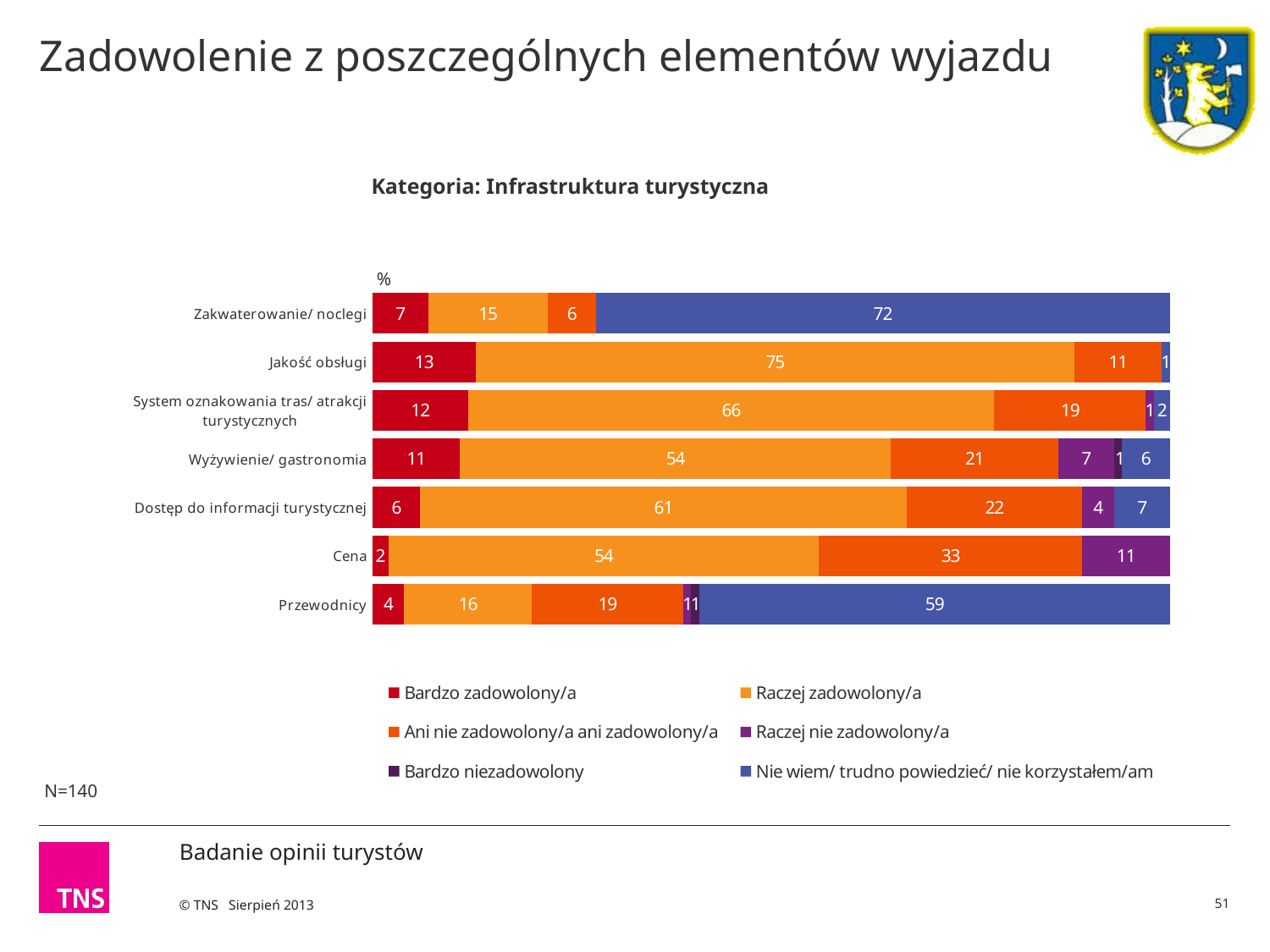
What is the value of "Raczej zadowolony/a" for "Jakość obsługi"? 75 Which is larger: the "Bardzo zadowolony/a" value for "Jakość obsługi" or for "Dostęp do informacji turystycznej"? Jakość obsługi What is the subtitle shown above the chart? Kategoria: Infrastruktura turystyczna What is the total of the stacked bar for "Przewodnicy"? 100 Which category has the highest value for "Raczej zadowolony/a"? Jakość obsługi Which category has the lowest value for "Bardzo zadowolony/a"? Cena What is the difference between the "Raczej zadowolony/a" values for "System oznakowania tras/ atrakcji turystycznych" and "Wyżywienie/ gastronomia"? 12 How many series does the legend list? 6 What is the value of "Nie wiem/ trudno powiedzieć/ nie korzystałem/am" for "Zakwaterowanie/ noclegi"? 72 What type of chart is shown on the slide? Stacked bar chart How many categories are plotted on the chart? 7 What is the value of "Ani nie zadowolony/a ani zadowolony/a" for "Cena"? 33